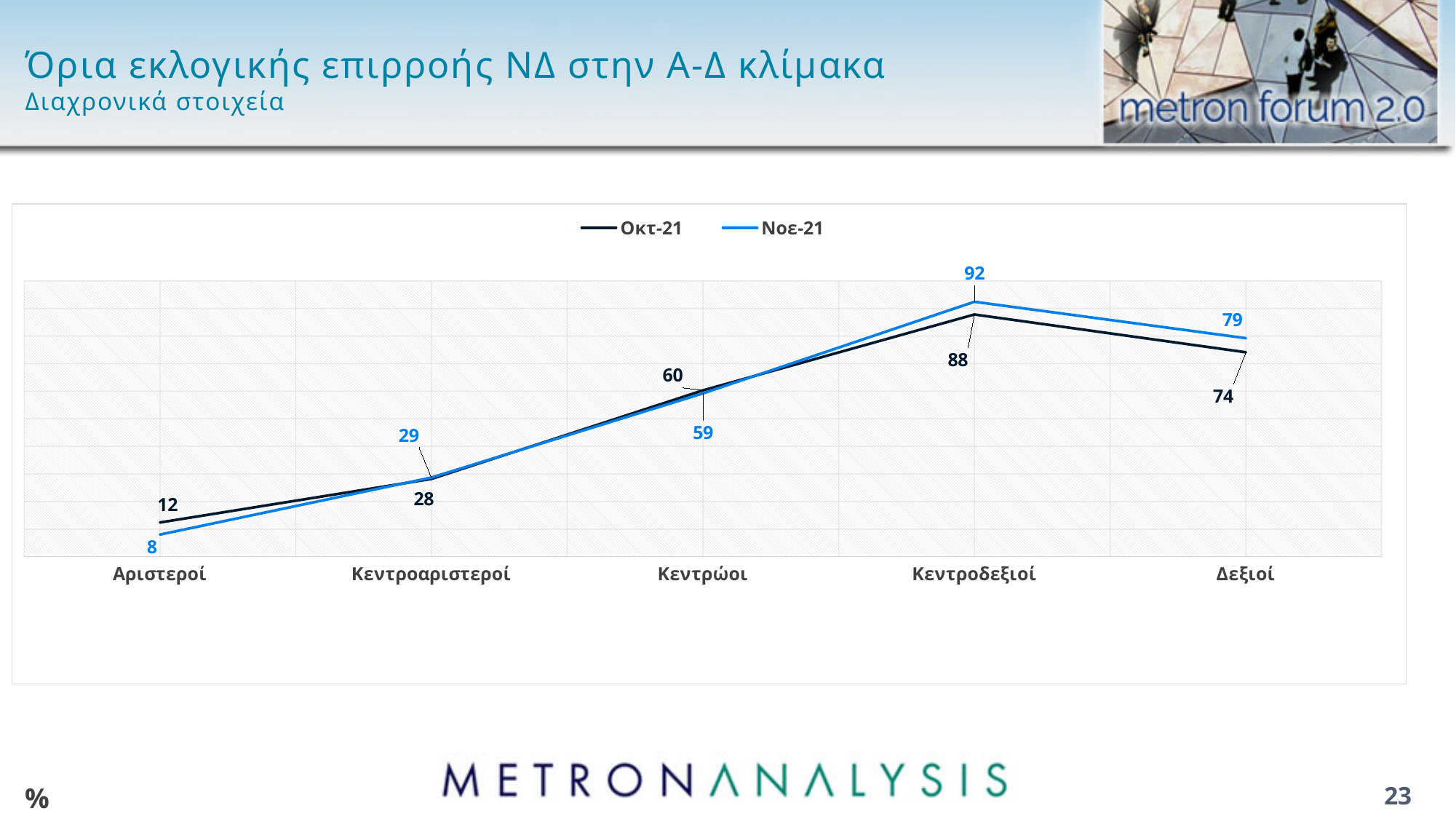
Which category has the highest value in the Νοε-21 series? Κεντροδεξιοί What is the value for Κεντροδεξιοί in the Νοε-21 series? 92 How many series does the legend list? 2 What is the value for Δεξιοί in the Νοε-21 series? 79 How many categories are shown on the x axis? 5 What kind of chart is shown on the slide? line chart What is the value for Αριστεροί in the Οκτ-21 series? 12 Which category has the lowest value in the Οκτ-21 series? Αριστεροί What is the value for Κεντρώοι in the Οκτ-21 series? 60 Which is larger for Αριστεροί: the Οκτ-21 value or the Νοε-21 value? Οκτ-21 Does the Νοε-21 series rise or fall from Αριστεροί to Κεντροδεξιοί? rise What is the difference between the Νοε-21 and Οκτ-21 values for Δεξιοί? 5